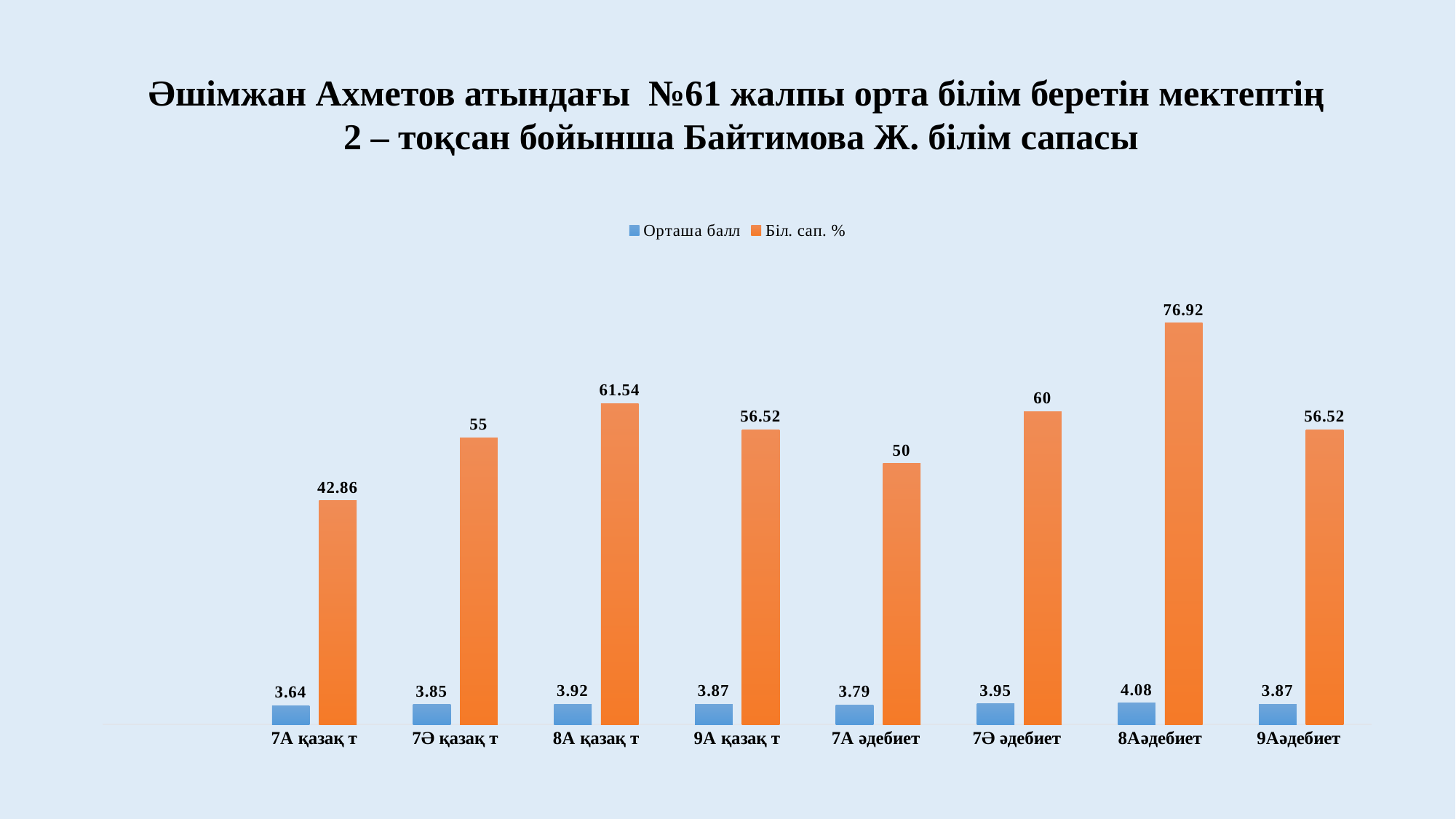
Which category has the highest Біл. сап. % value? 8Аәдебиет What is the difference between the Біл. сап. % values for 8А қазақ т and 7Ә қазақ т? 6.54 What is the Орташа балл value for 7А қазақ т? 3.64 What kind of chart is shown on the slide? bar chart Which colour represents the Біл. сап. % series? orange What is the Біл. сап. % value for 8Аәдебиет? 76.92 Which is larger, the Біл. сап. % value for 9А қазақ т or for 7А әдебиет? 9А қазақ т Which category has the lowest Біл. сап. % value? 7А қазақ т How many series does the legend list? 2 What is the Біл. сап. % value for 7Ә әдебиет? 60 How many categories are shown on the x axis? 8 Which category has the highest Орташа балл value? 8Аәдебиет